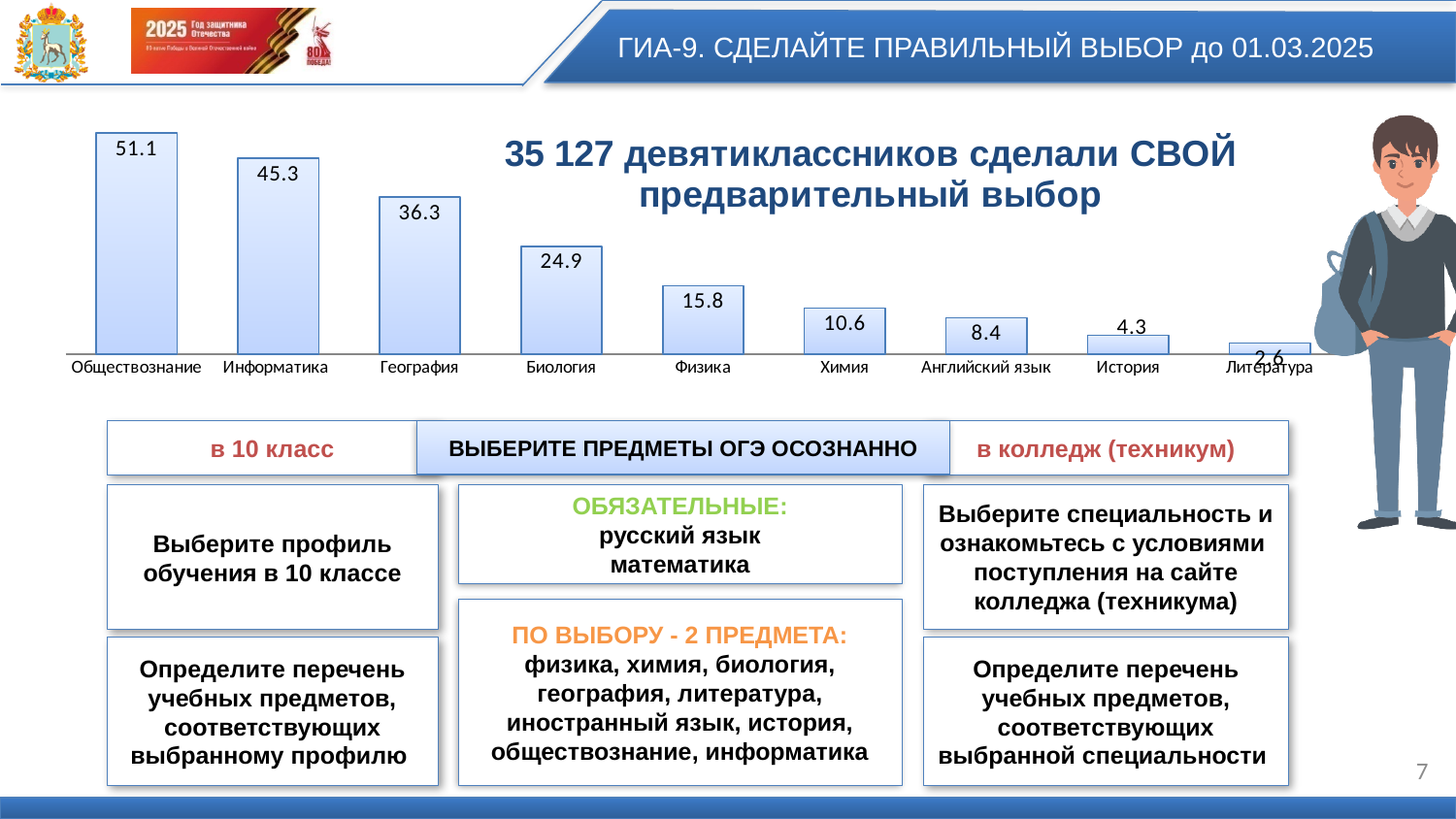
Which subject has the lowest value in the chart? Литература What is the value shown for Биология? 24.9 What type of chart is shown on the slide? Bar chart What is the difference between the values for География and Физика? 20.5 Which has a larger value, Химия or История? Химия Which has a larger value, Биология or Информатика? Информатика What is the difference between the values for Обществознание and Информатика? 5.8 What is the value shown for Английский язык? 8.4 Which subject has the highest value in the chart? Обществознание How many subjects are shown in the chart? 9 What is the value shown for Обществознание? 51.1 Do the values rise or fall from left to right across the subjects? Fall